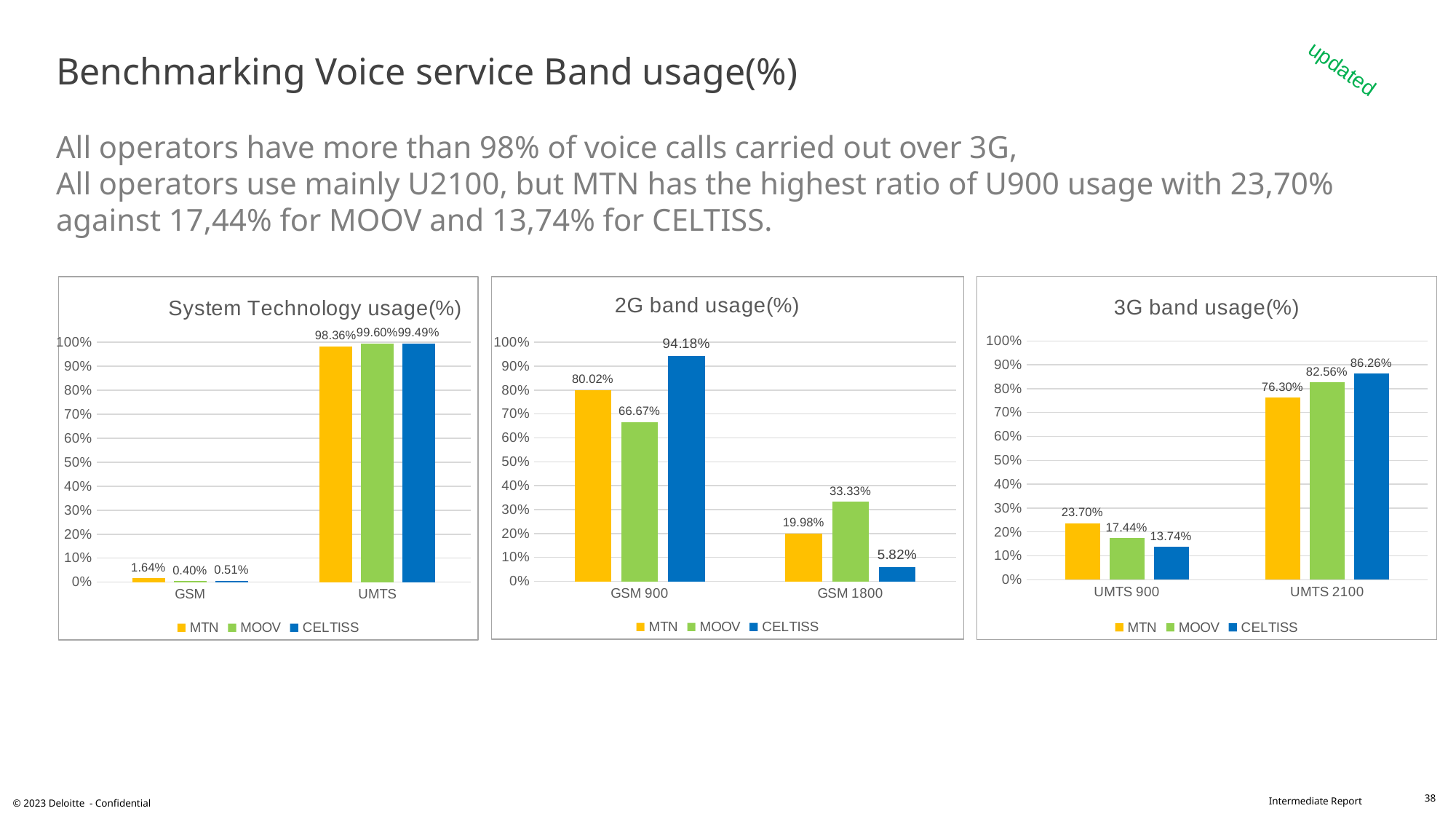
In the '3G band usage(%)' chart, what is the difference between CELTISS's UMTS 2100 value and MTN's UMTS 2100 value? 9.96% In the '2G band usage(%)' chart, which operator has the lowest GSM 1800 value? CELTISS How many categories are shown on the x axis of the '3G band usage(%)' chart? 2 In the '2G band usage(%)' chart, what is the difference between MTN's GSM 900 value and MOOV's GSM 900 value? 13.35% In the '2G band usage(%)' chart, what is the value for CELTISS under GSM 900? 94.18% In the '3G band usage(%)' chart, is MTN's UMTS 900 value larger or smaller than CELTISS's UMTS 900 value? larger How many series does the legend of the '2G band usage(%)' chart list? 3 What kind of chart is the 'System Technology usage(%)' chart? Bar chart In the 'System Technology usage(%)' chart, which operator has the highest UMTS value? MOOV In the 'System Technology usage(%)' chart, what is the value for MTN under GSM? 1.64% In the '3G band usage(%)' chart, what is the value for MOOV under UMTS 900? 17.44% In the '3G band usage(%)' chart, which operator has the highest UMTS 2100 value? CELTISS